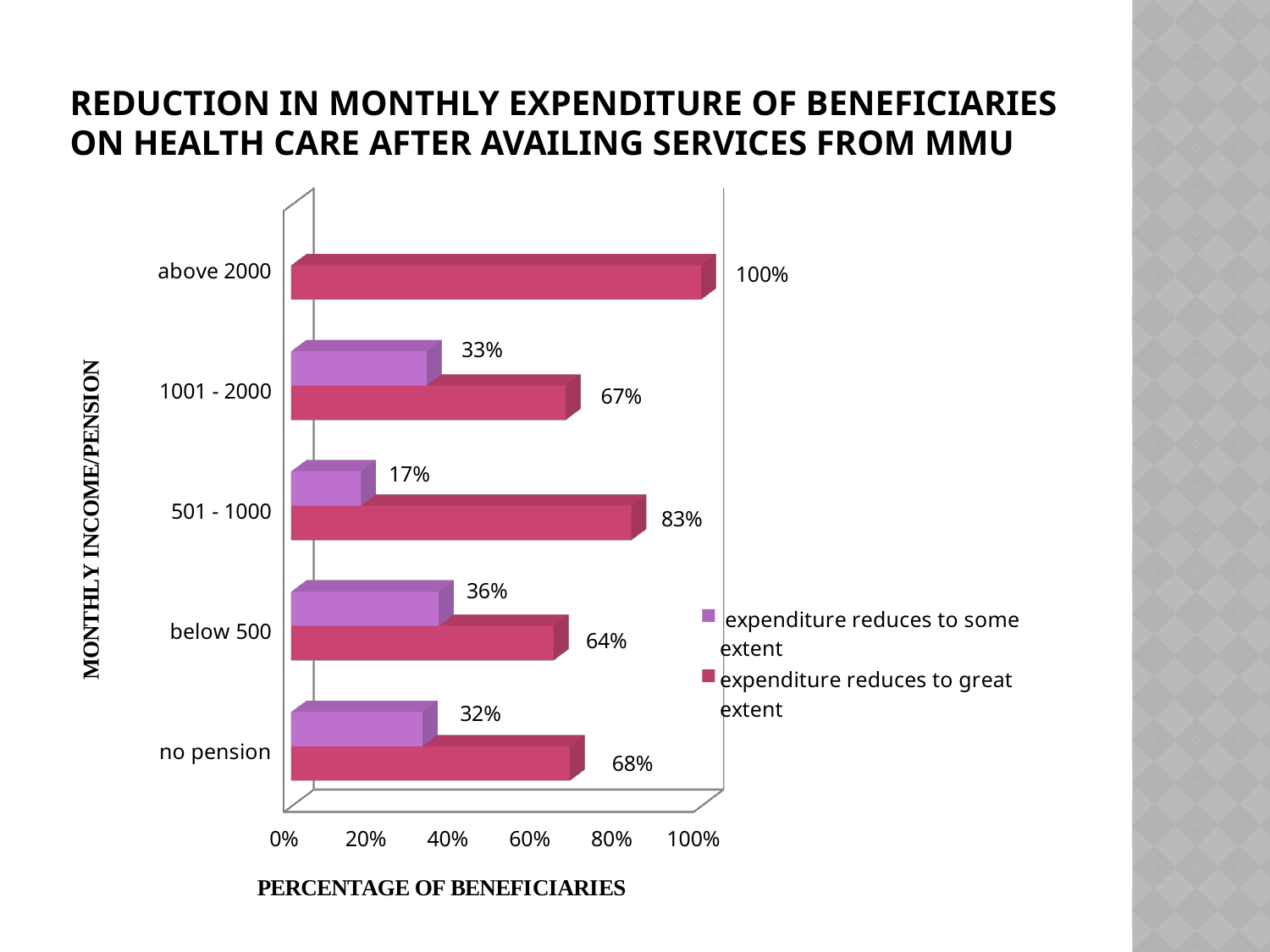
Which income group has the lowest value for 'expenditure reduces to some extent' among those with a plotted value? 501 - 1000 What is the value for 'expenditure reduces to great extent' in the 501 - 1000 income group? 83% What percentage of beneficiaries with monthly income above 2000 reported that expenditure reduces to a great extent? 100% How many income categories are shown on the y axis? 5 What is the difference between the 'great extent' and 'some extent' values for the below 500 income group? 28% What type of chart is shown on the slide? bar chart What is the label of the x axis? PERCENTAGE OF BENEFICIARIES Which is larger for the no pension group: 'expenditure reduces to some extent' or 'expenditure reduces to great extent'? expenditure reduces to great extent What is the value for 'expenditure reduces to some extent' for beneficiaries with no pension? 32% Which income group has the highest value for 'expenditure reduces to great extent'? above 2000 What is the value for 'expenditure reduces to some extent' in the 1001 - 2000 income group? 33% How many series does the legend list? 2